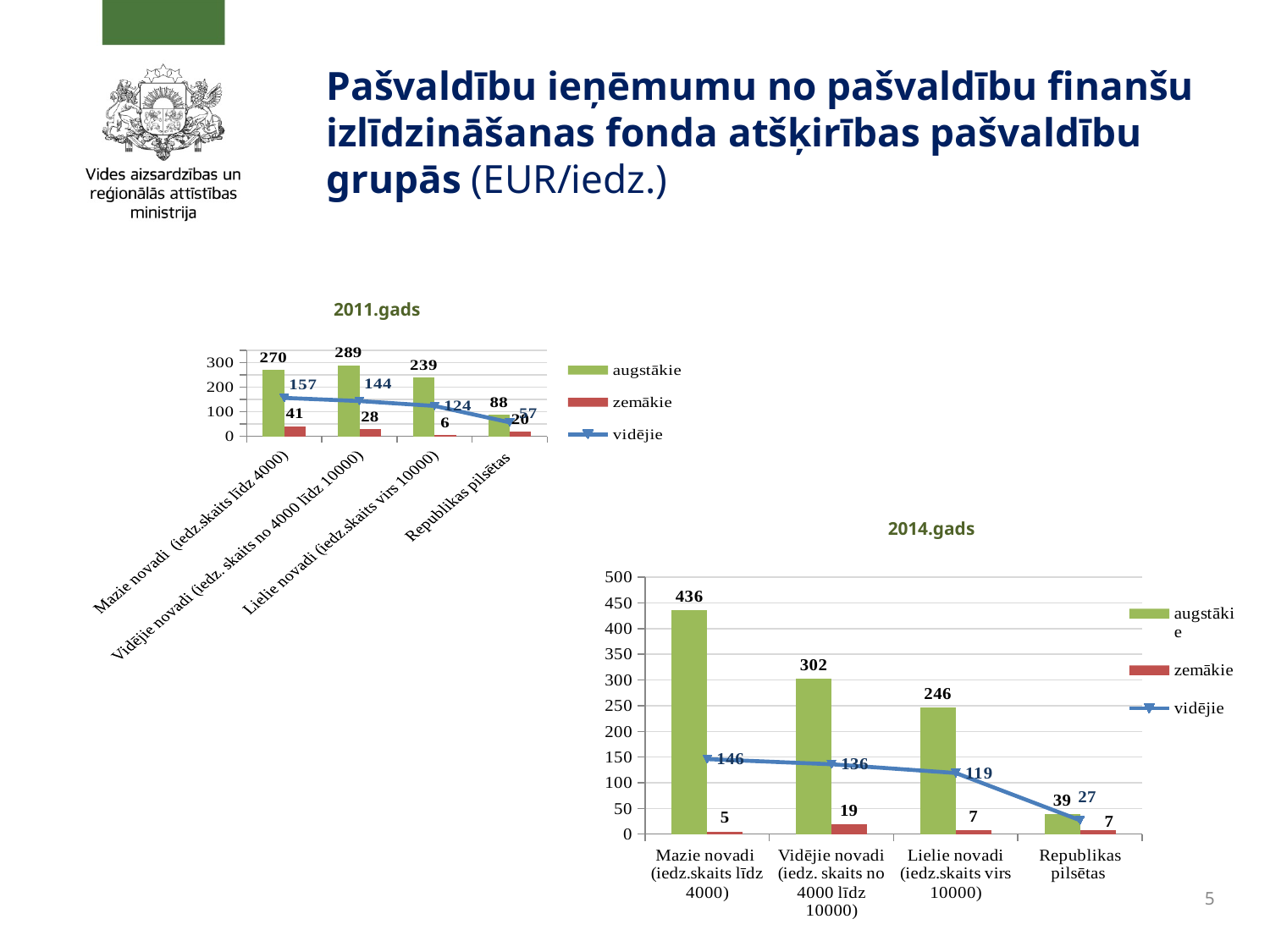
In the 2011.gads chart, what is the difference between the augstākie and zemākie values for Mazie novadi (iedz.skaits līdz 4000)? 229 In the 2011.gads chart, what is the augstākie value for Mazie novadi (iedz.skaits līdz 4000)? 270 In the 2014.gads chart, what is the augstākie value for Mazie novadi (iedz.skaits līdz 4000)? 436 In the 2014.gads chart, does the vidējie line rise or fall from Mazie novadi to Republikas pilsētas? fall In the 2011.gads chart, what is the zemākie value for Lielie novadi (iedz.skaits virs 10000)? 6 In the 2011.gads chart, what is the vidējie value for Republikas pilsētas? 57 How many series does the legend of the 2014.gads chart list? 3 In the 2014.gads chart, which category has the lowest augstākie value? Republikas pilsētas In the 2014.gads chart, what is the zemākie value for Vidējie novadi (iedz. skaits no 4000 līdz 10000)? 19 In the 2011.gads chart, which category has the highest augstākie value? Vidējie novadi (iedz. skaits no 4000 līdz 10000) How many categories are shown on the x axis of the 2011.gads chart? 4 In the 2014.gads chart, which is larger: the vidējie value for Lielie novadi (iedz.skaits virs 10000) or the vidējie value for Republikas pilsētas? Lielie novadi (iedz.skaits virs 10000)